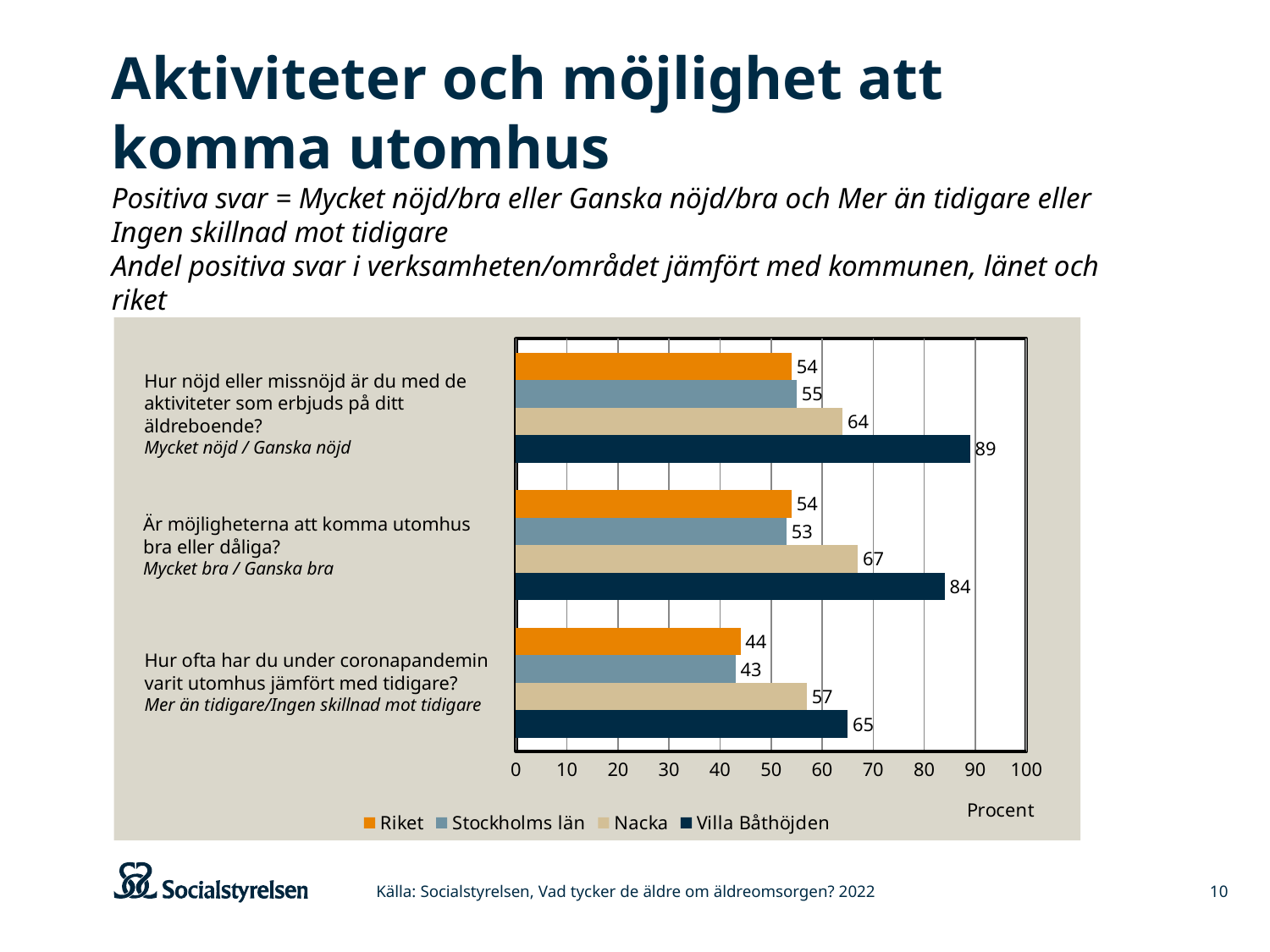
What is the label on the horizontal axis of the chart? Procent Which series has the highest value on the question about opportunities to get outdoors (Är möjligheterna att komma utomhus bra eller dåliga?)? Villa Båthöjden How many series does the legend list? 4 What is the value for Stockholms län on the question about how often respondents have been outdoors during the pandemic compared to before? 43 What kind of chart is shown on the slide? Bar chart What is the value for Nacka on the question about opportunities to get outdoors (Är möjligheterna att komma utomhus bra eller dåliga?)? 67 What is the difference between Villa Båthöjden and Nacka on the question about satisfaction with activities offered at the care home? 25 What is the value for Riket on the question about how often respondents have been outdoors during the pandemic compared to before? 44 What is the value for Villa Båthöjden on the question about satisfaction with activities offered at the care home (Hur nöjd eller missnöjd är du med de aktiviteter som erbjuds på ditt äldreboende?)? 89 Which series has the lowest value on the question about how often respondents have been outdoors during the pandemic compared to before? Stockholms län What is the difference between Villa Båthöjden and Riket on the question about opportunities to get outdoors? 30 Which is larger on the question about satisfaction with activities: the value for Riket or the value for Nacka? Nacka